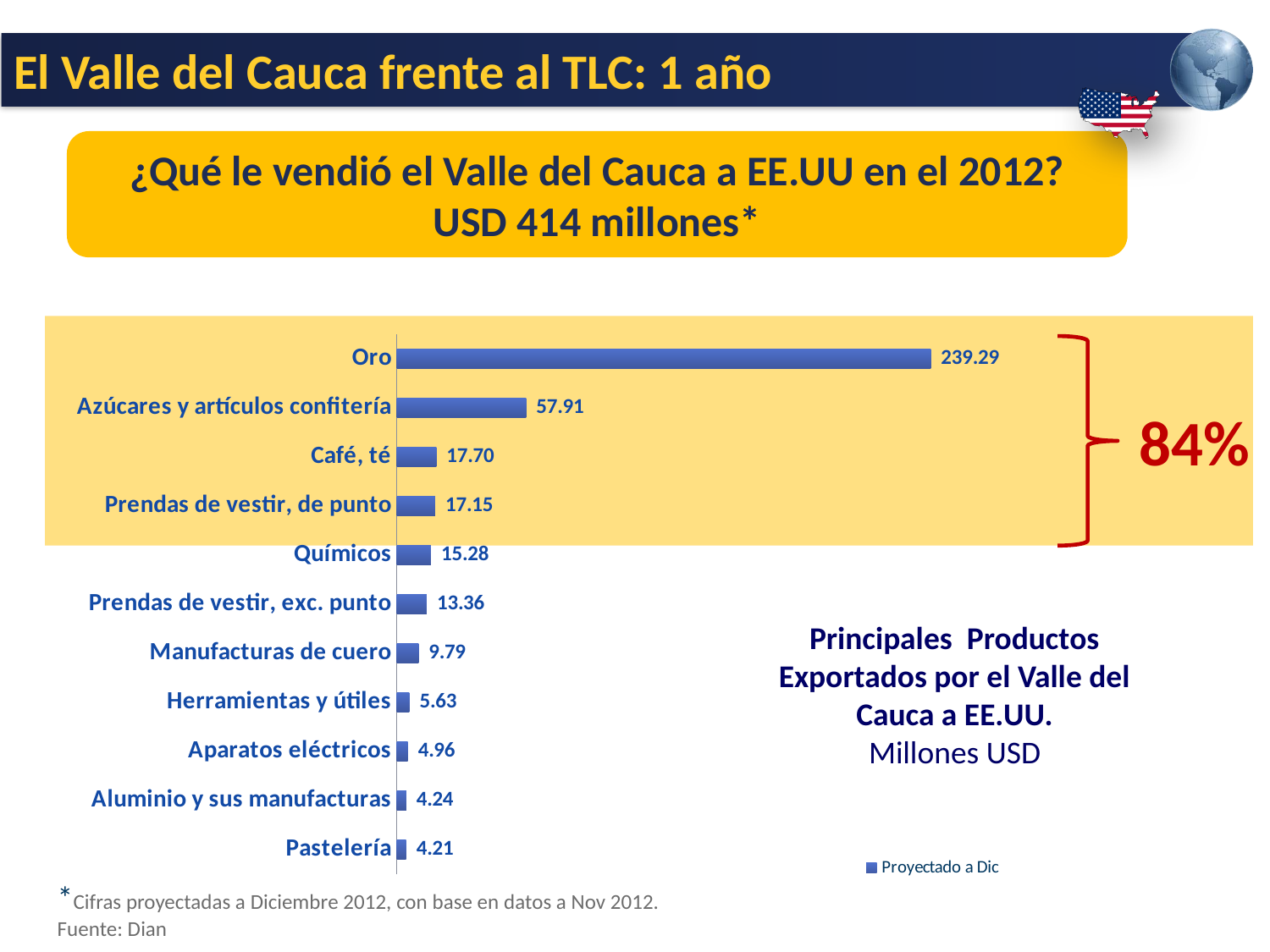
What is the difference between the values for Oro and Azúcares y artículos confitería? 181.38 What is the legend entry of the chart? Proyectado a Dic What is the difference between the values for Café, té and Prendas de vestir, de punto? 0.55 Which is larger, the value for Químicos or the value for Prendas de vestir, exc. punto? Químicos What is the value for Oro? 239.29 What is the value for Manufacturas de cuero? 9.79 What kind of chart is shown on the slide? Bar chart Which category has the lowest value? Pastelería How many categories are shown in the chart? 11 How many series does the legend list? 1 Which category has the highest value? Oro What is the value for Azúcares y artículos confitería? 57.91